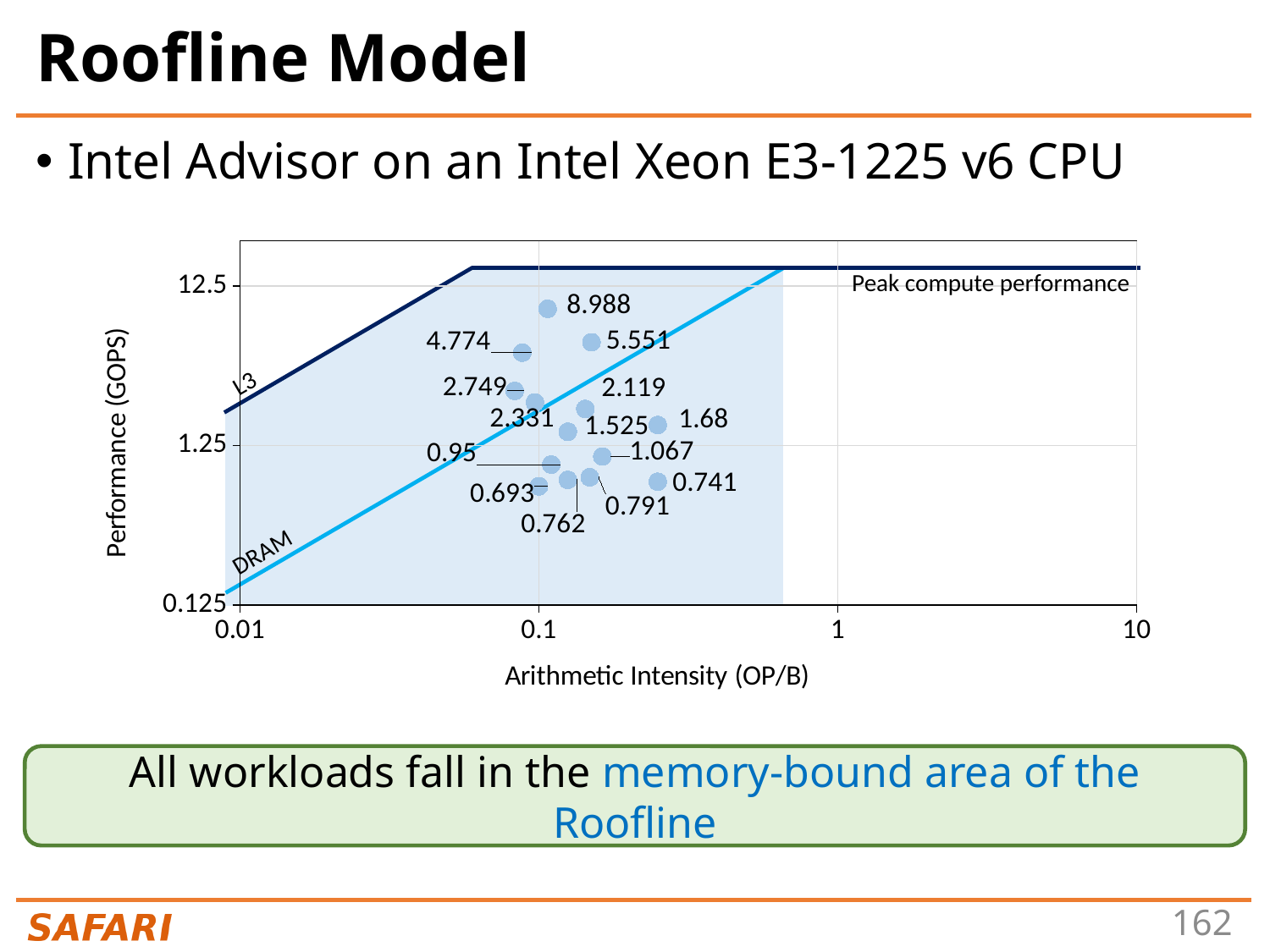
How many labelled workload points are plotted on the chart? 14 Which labelled value is larger, 5.551 or 4.774? 5.551 Is the highest plotted workload point (8.988) greater or less than 12.5 GOPS? less What is the label of the x axis? Arithmetic Intensity (OP/B) What is the lowest performance value labelled among the plotted workload points? 0.693 Is the workload point labelled 0.741 greater or less than 1.25 GOPS? less What are the tick values shown on the x axis? 0.01, 0.1, 1, 10 What is the difference between the labelled values 2.749 and 2.331? 0.418 What is the difference between the highest labelled value (8.988) and the lowest labelled value (0.693)? 8.295 What kind of chart is shown on the slide? Scatter chart What is the label of the y axis? Performance (GOPS) What is the highest performance value labelled among the plotted workload points? 8.988